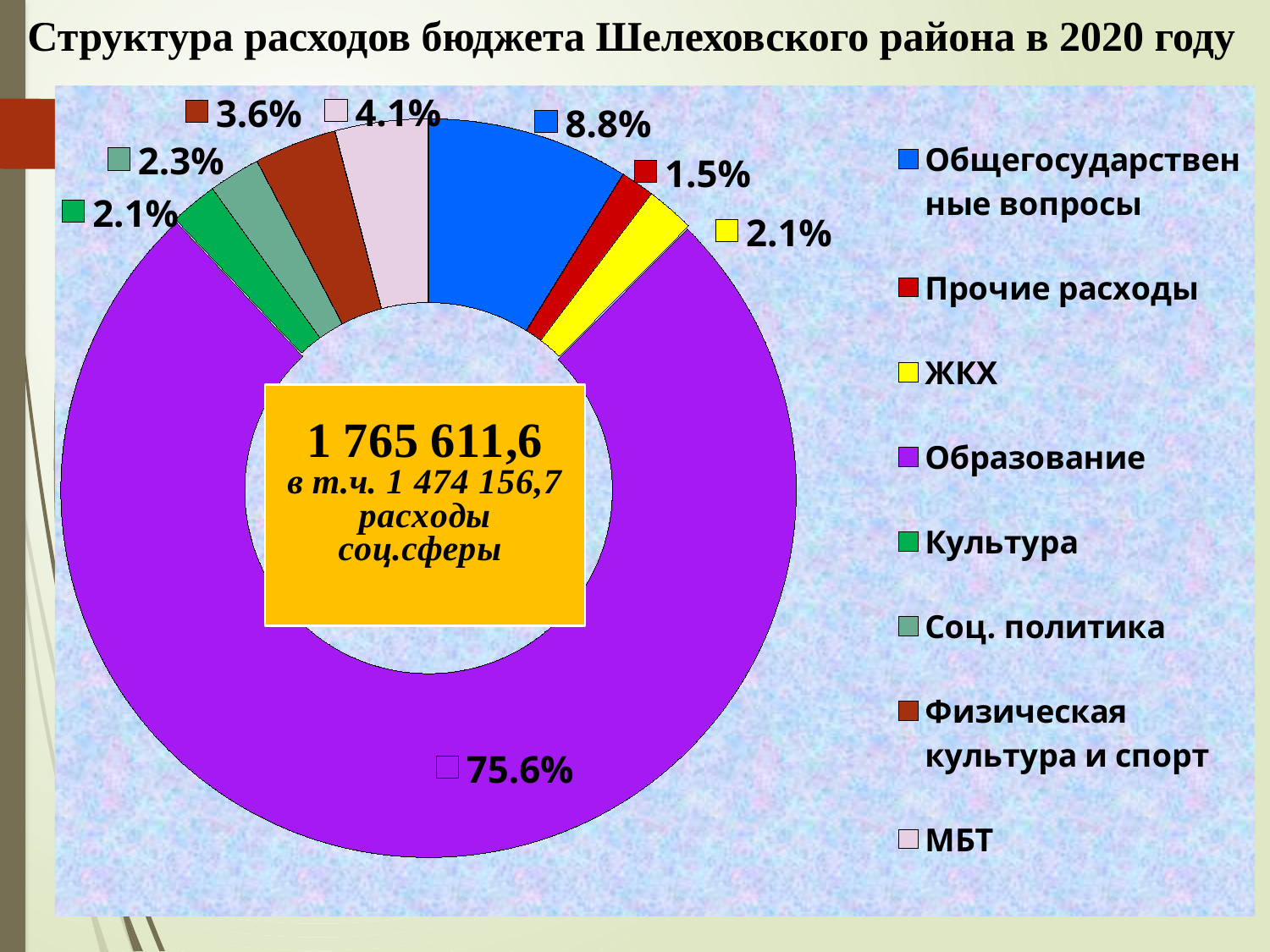
What percentage is shown for МБТ? 4.1% Which category has the smallest share of expenditure? Прочие расходы Which colour represents Образование in the chart? Purple What kind of chart is shown on the slide? Doughnut (pie) chart Which category has the largest share of expenditure? Образование What percentage is shown for Физическая культура и спорт? 3.6% How many categories does the legend list? 8 What is the difference in percentage points between Образование and Общегосударственные вопросы? 66.8 What total value is printed in the centre of the chart? 1 765 611,6 What share of the budget expenditure goes to Образование? 75.6% Which is larger, the share for Соц. политика or the share for Физическая культура и спорт? Физическая культура и спорт What percentage is shown for Общегосударственные вопросы? 8.8%